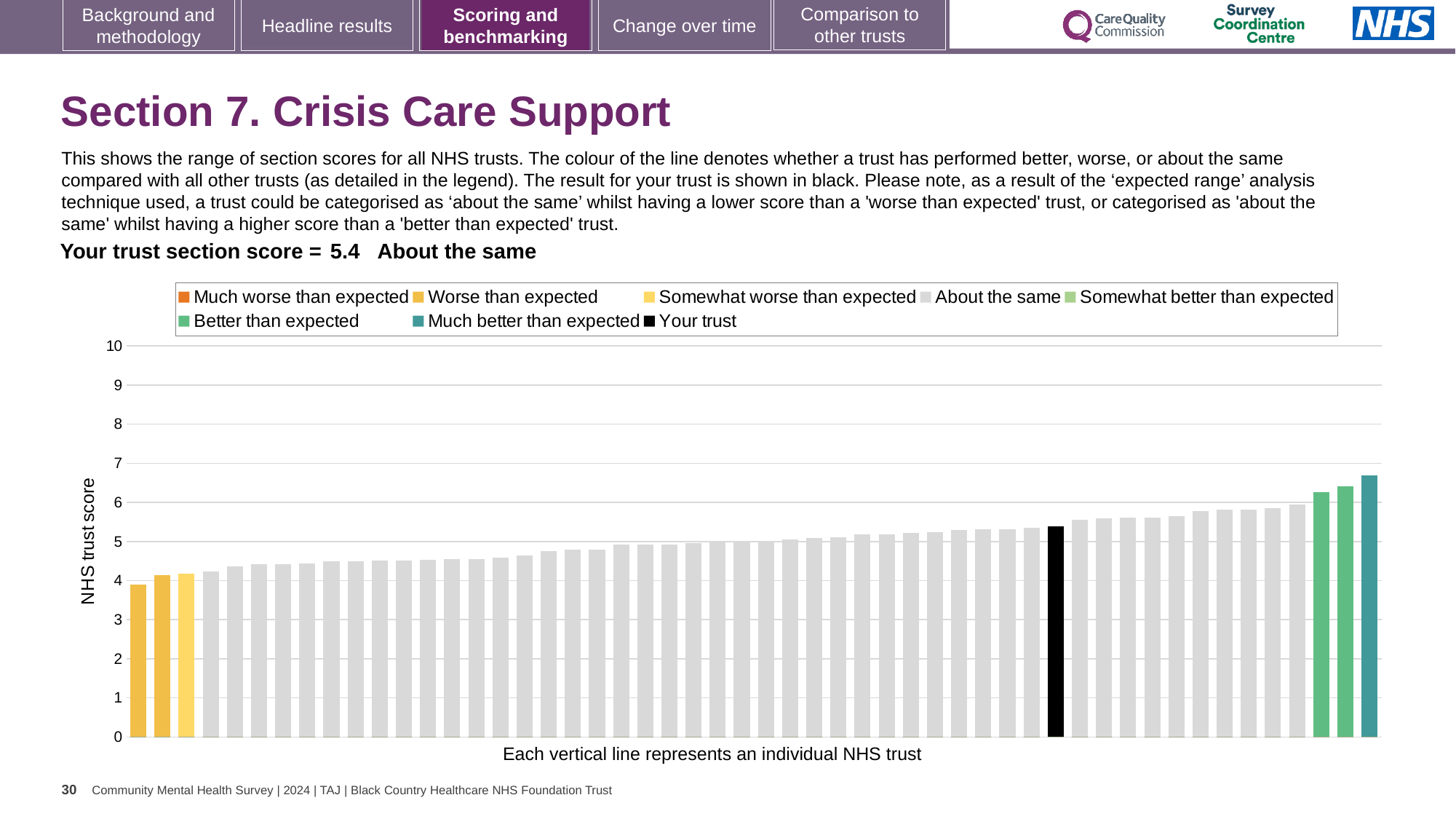
How many entries does the chart legend list? 8 What is the label on the vertical axis of the chart? NHS trust score Is the value of the tallest bar in the chart greater or less than 6? greater Is the value of the black 'Your trust' bar greater or less than 5? greater Is the value of the shortest bar in the chart greater or less than 5? less Which legend category does the tallest bar (teal, far right) belong to? Much better than expected Do the bar values rise or fall from left to right along the x axis? rise What is the highest value shown on the vertical axis? 10 What colour is the bar representing your trust? black What is the section score for your trust shown on the slide? 5.4 What kind of chart is shown on the slide? bar chart How is your trust's section score categorised compared with other trusts? About the same